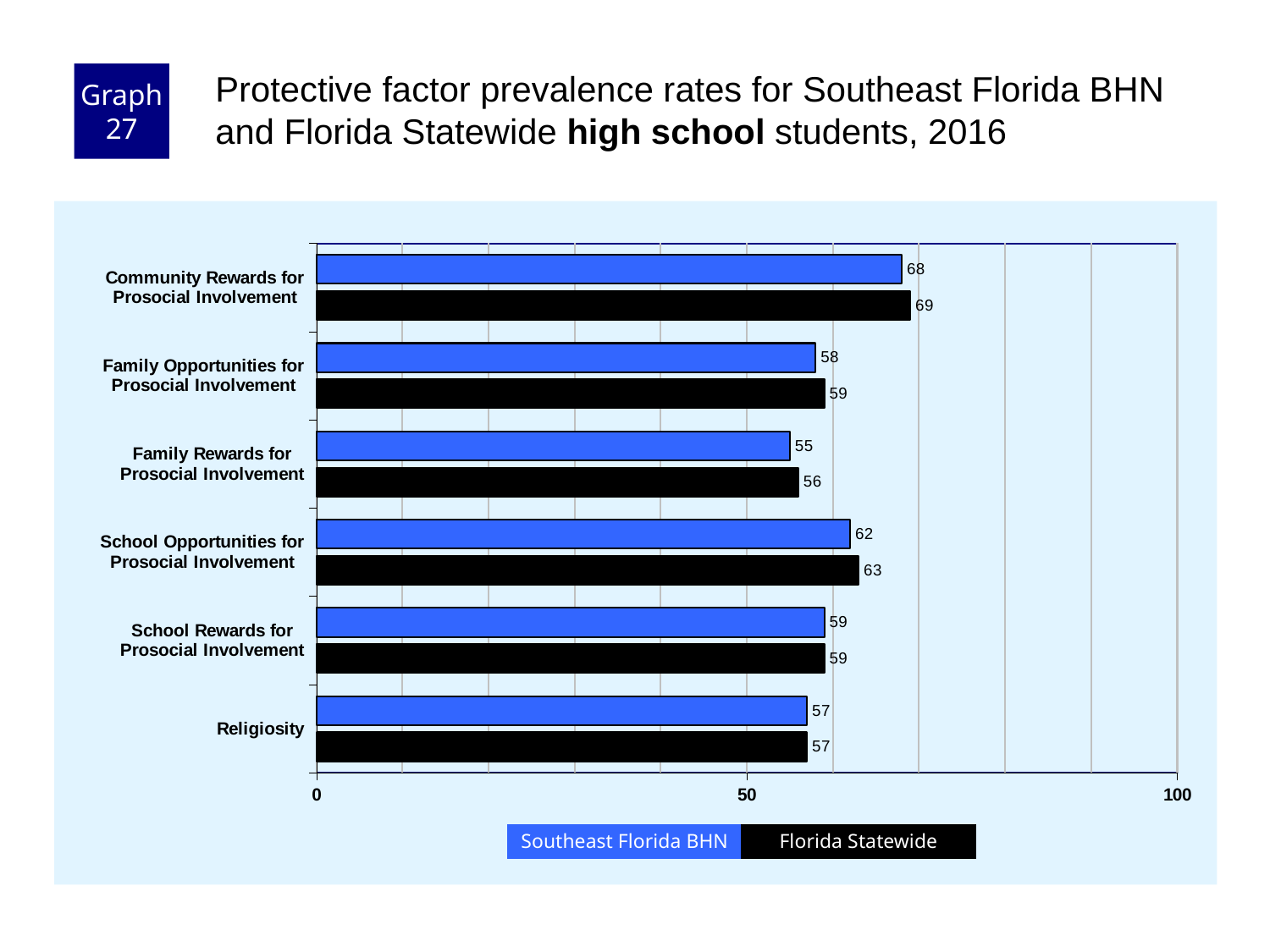
How many series does the legend list? 2 Which category has the lowest Southeast Florida BHN value? Family Rewards for Prosocial Involvement What is the Southeast Florida BHN value for Religiosity? 57 Is the Southeast Florida BHN value for School Rewards for Prosocial Involvement greater or less than 50? greater What is the Southeast Florida BHN value for Community Rewards for Prosocial Involvement? 68 Which category has the highest Florida Statewide value? Community Rewards for Prosocial Involvement What kind of chart is shown on the slide? Bar chart What is the difference between the Florida Statewide and Southeast Florida BHN values for School Opportunities for Prosocial Involvement? 1 How many protective factor categories are shown on the chart? 6 Which colour represents Florida Statewide in the chart? Black Which is larger for Family Rewards for Prosocial Involvement: the Southeast Florida BHN value or the Florida Statewide value? Florida Statewide What is the Florida Statewide value for Family Opportunities for Prosocial Involvement? 59